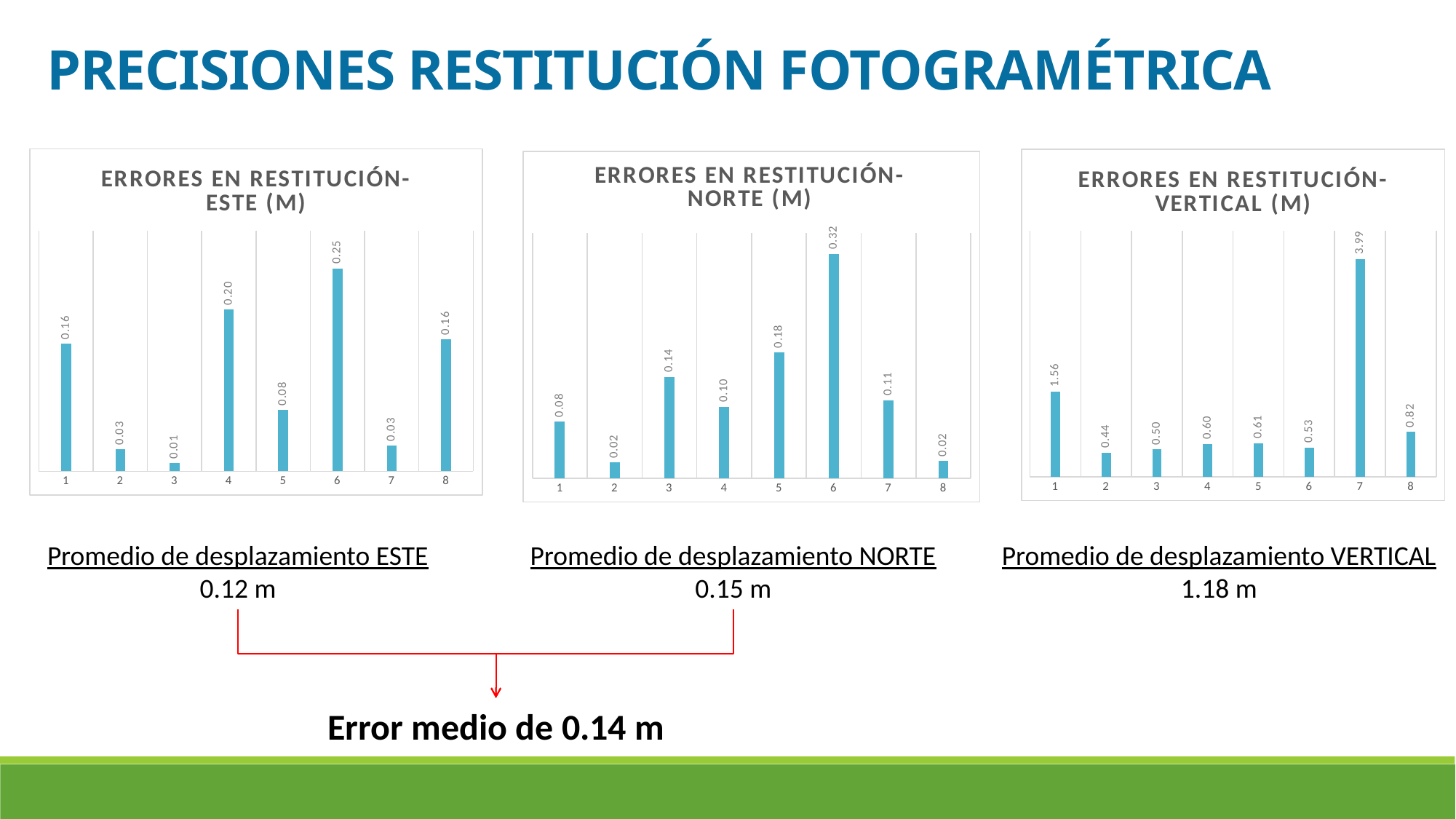
What kind of chart is the 'ERRORES EN RESTITUCIÓN-NORTE (M)' chart? bar chart In the 'ERRORES EN RESTITUCIÓN-ESTE (M)' chart, what is the value for category 4? 0.20 In the 'ERRORES EN RESTITUCIÓN-ESTE (M)' chart, which category has the highest value? 6 How many categories are shown in the 'ERRORES EN RESTITUCIÓN-ESTE (M)' chart? 8 In the 'ERRORES EN RESTITUCIÓN-VERTICAL (M)' chart, which category has the lowest value? 2 In the 'ERRORES EN RESTITUCIÓN-VERTICAL (M)' chart, what is the value for category 7? 3.99 In the 'ERRORES EN RESTITUCIÓN-NORTE (M)' chart, which category has the lowest value? 2 and 8 In the 'ERRORES EN RESTITUCIÓN-NORTE (M)' chart, what is the value for category 6? 0.32 In the 'ERRORES EN RESTITUCIÓN-VERTICAL (M)' chart, which is larger, the value for category 1 or category 8? 1 In the 'ERRORES EN RESTITUCIÓN-ESTE (M)' chart, what is the difference between the values for category 6 and category 1? 0.09 In the 'ERRORES EN RESTITUCIÓN-NORTE (M)' chart, what is the difference between the values for category 6 and category 5? 0.14 In the 'ERRORES EN RESTITUCIÓN-ESTE (M)' chart, which category has the lowest value? 3